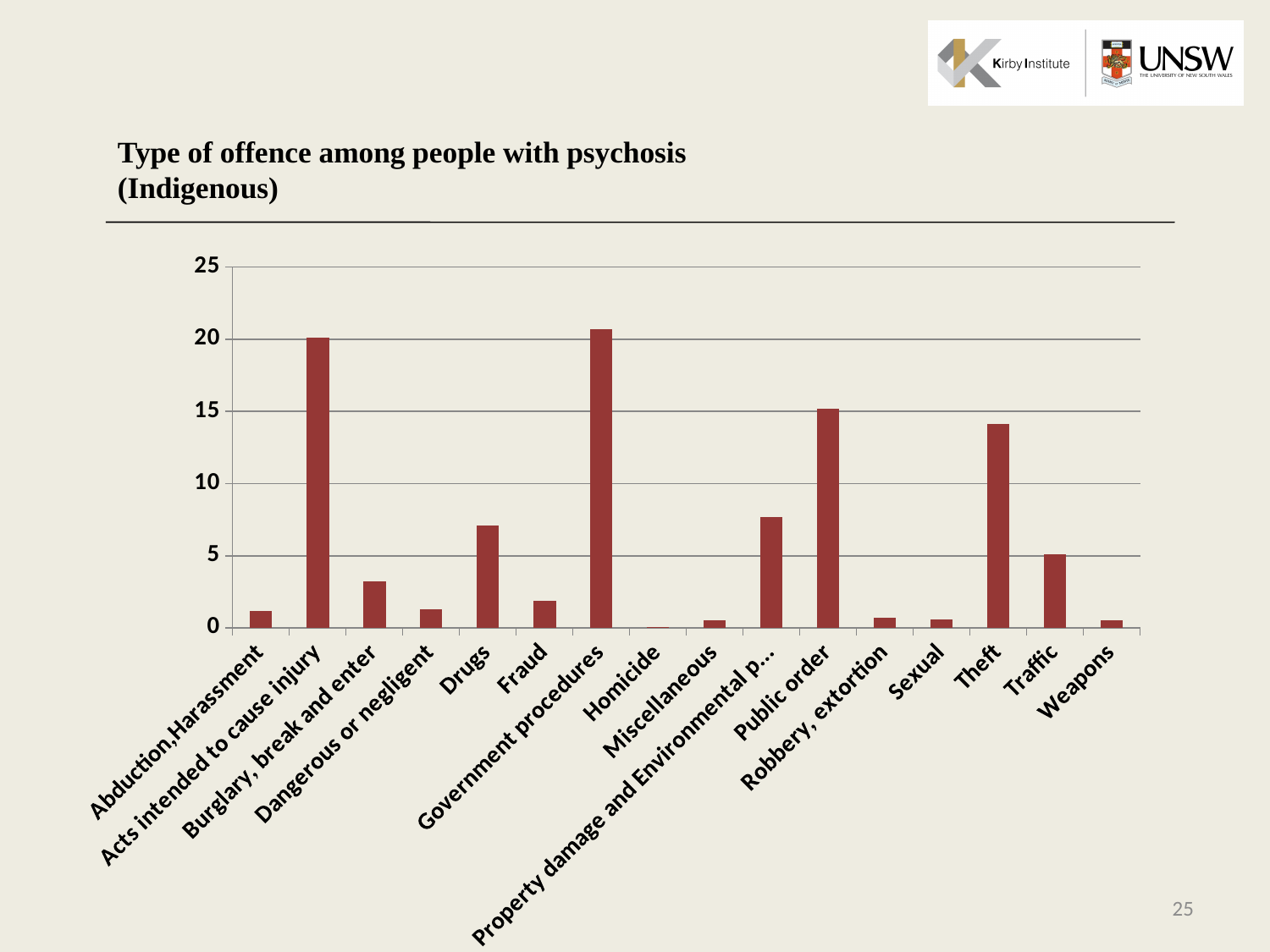
Is the value for Public order greater or less than 10? greater Which has the larger value, Acts intended to cause injury or Public order? Acts intended to cause injury Which has the larger value, Theft or Traffic? Theft How many offence categories are shown on the x axis of the chart? 16 Is the value for Drugs greater or less than 10? less Is the value for Acts intended to cause injury greater or less than 15? greater What kind of chart is shown on the slide? Bar chart Which has the larger value, Drugs or Fraud? Drugs Which offence category has the lowest value in the chart? Homicide What is the title of the chart on the slide? Type of offence among people with psychosis (Indigenous)